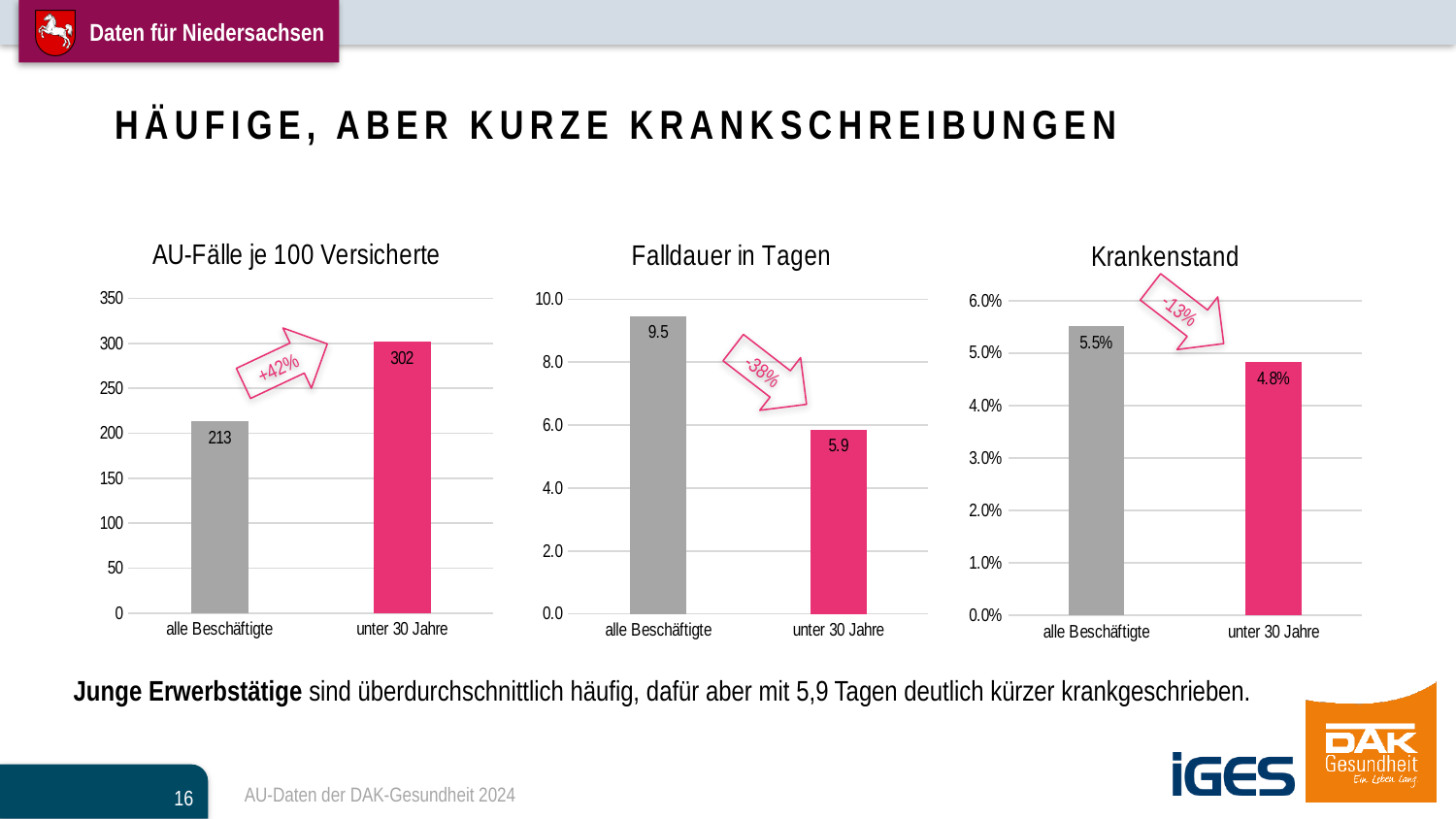
What kind of chart is the 'Krankenstand' chart? bar chart In the 'Falldauer in Tagen' chart, what is the value for 'alle Beschäftigte'? 9.5 How many categories does the 'Falldauer in Tagen' chart show? 2 In the 'AU-Fälle je 100 Versicherte' chart, what is the difference between 'unter 30 Jahre' and 'alle Beschäftigte'? 89 In the 'Falldauer in Tagen' chart, which category has the lower value? unter 30 Jahre In the 'Krankenstand' chart, which category has the higher value? alle Beschäftigte In the 'Krankenstand' chart, what is the value for 'unter 30 Jahre'? 4.8% In the 'Krankenstand' chart, what is the value for 'alle Beschäftigte'? 5.5% In the 'AU-Fälle je 100 Versicherte' chart, is the value for 'alle Beschäftigte' greater or less than 250? less In the 'AU-Fälle je 100 Versicherte' chart, what is the value for 'unter 30 Jahre'? 302 In the 'Falldauer in Tagen' chart, what is the value for 'unter 30 Jahre'? 5.9 In the 'AU-Fälle je 100 Versicherte' chart, what is the value for 'alle Beschäftigte'? 213